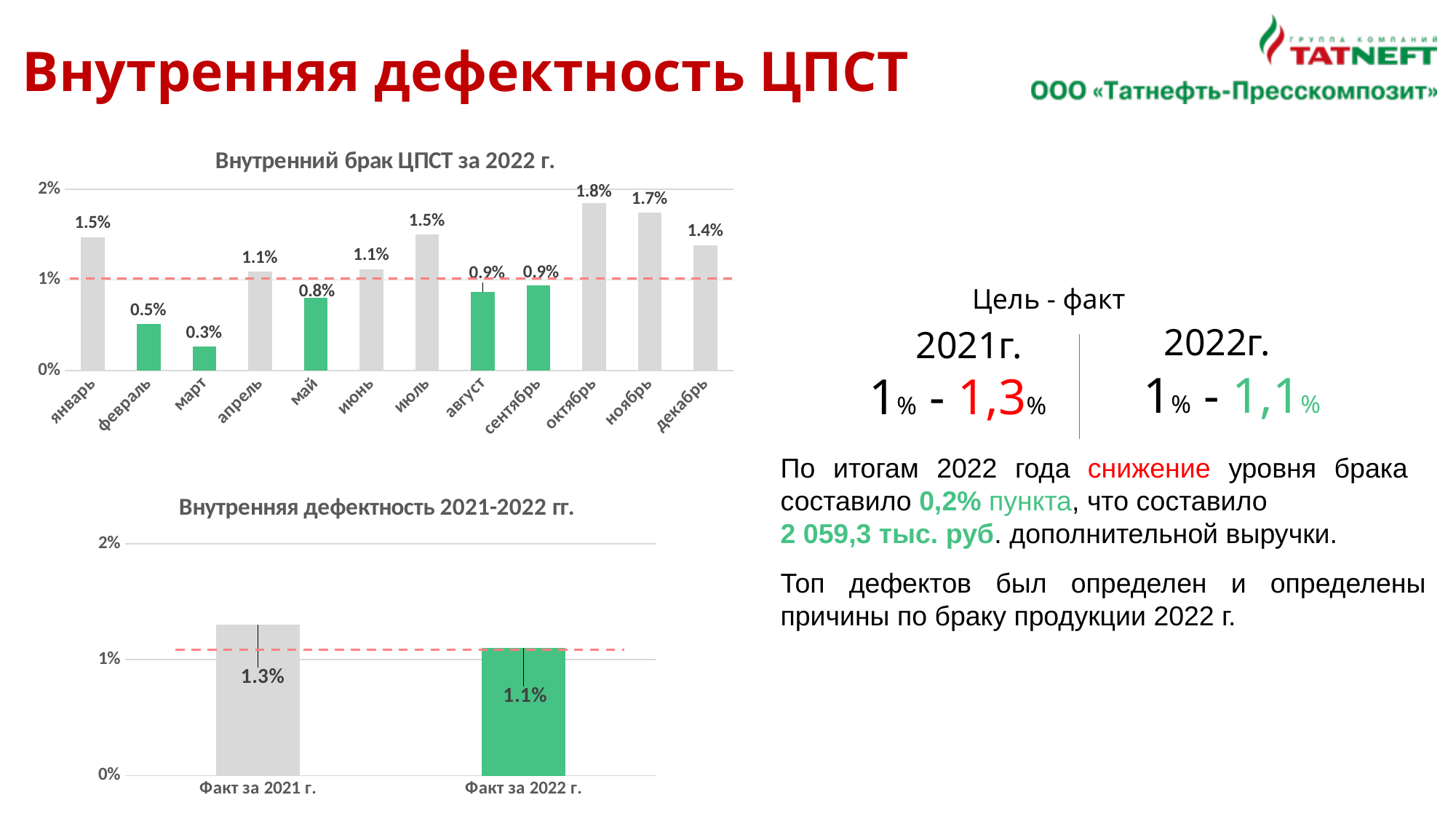
In the chart 'Внутренний брак ЦПСТ за 2022 г.', which month has the highest value? октябрь In the chart 'Внутренний брак ЦПСТ за 2022 г.', what is the value for март? 0.3% In the chart 'Внутренняя дефектность 2021-2022 гг.', what is the difference between 'Факт за 2021 г.' and 'Факт за 2022 г.'? 0.2% In the chart 'Внутренний брак ЦПСТ за 2022 г.', how many months are plotted? 12 In the chart 'Внутренний брак ЦПСТ за 2022 г.', is the value for февраль greater or less than 1%? less What type of chart is 'Внутренняя дефектность 2021-2022 гг.'? bar chart In the chart 'Внутренний брак ЦПСТ за 2022 г.', what colour are the bars for февраль, март, май, август and сентябрь? green In the chart 'Внутренний брак ЦПСТ за 2022 г.', which month has the lowest value? март In the chart 'Внутренний брак ЦПСТ за 2022 г.', what is the difference between the values for октябрь and март? 1.5% In the chart 'Внутренний брак ЦПСТ за 2022 г.', which is larger, the value for январь or the value for май? январь In the chart 'Внутренняя дефектность 2021-2022 гг.', what is the value for 'Факт за 2022 г.'? 1.1% In the chart 'Внутренний брак ЦПСТ за 2022 г.', what is the value for октябрь? 1.8%